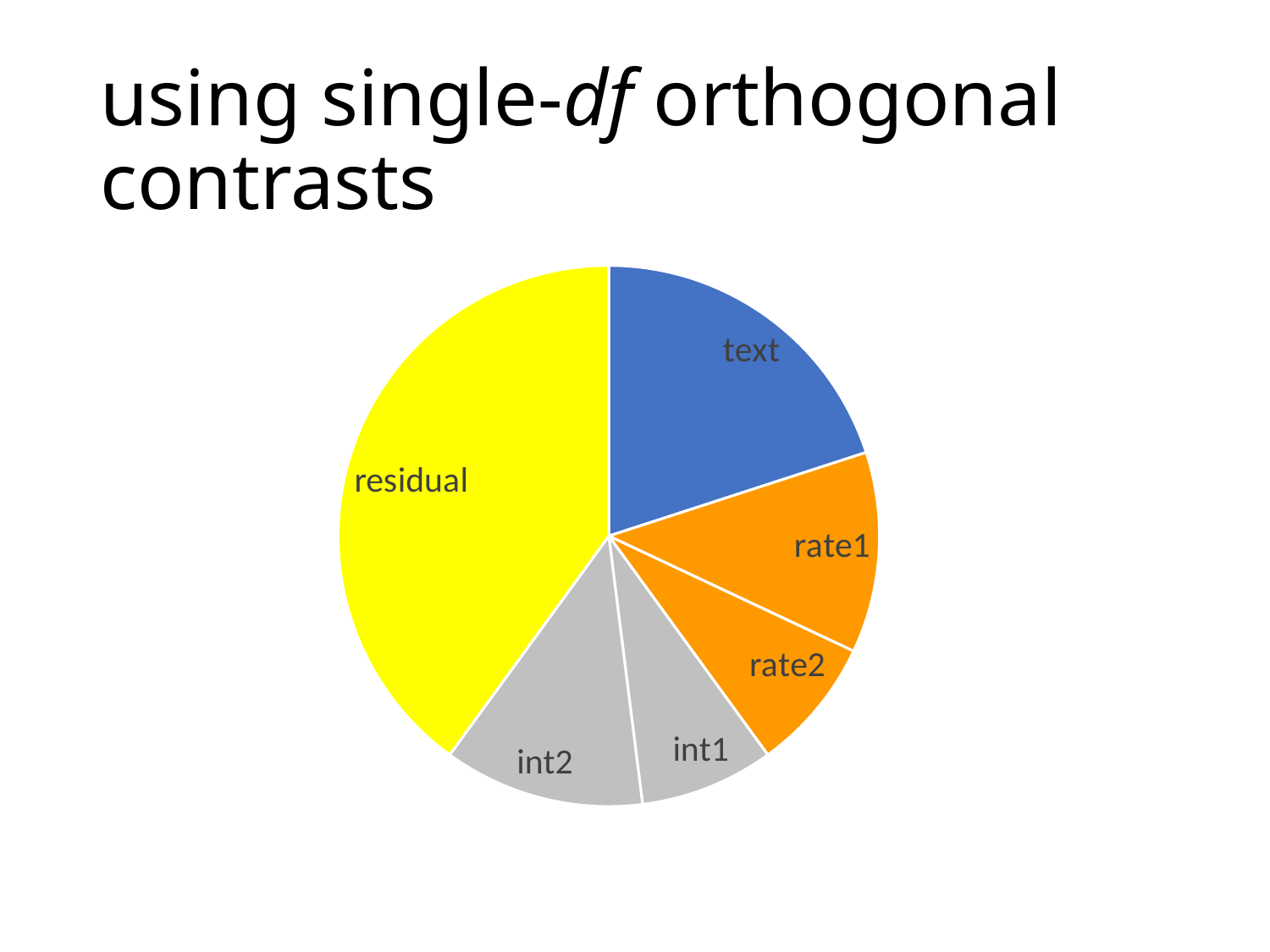
Which slice is larger, rate1 or rate2? rate1 What kind of chart is shown on the slide? pie chart Which two slices of the pie chart are coloured orange? rate1 and rate2 Which slice is larger, residual or text? residual What colour is the residual slice of the pie chart? yellow Which slice is larger, int2 or int1? int2 Which slice of the pie chart is the largest? residual How many slices does the pie chart have? 6